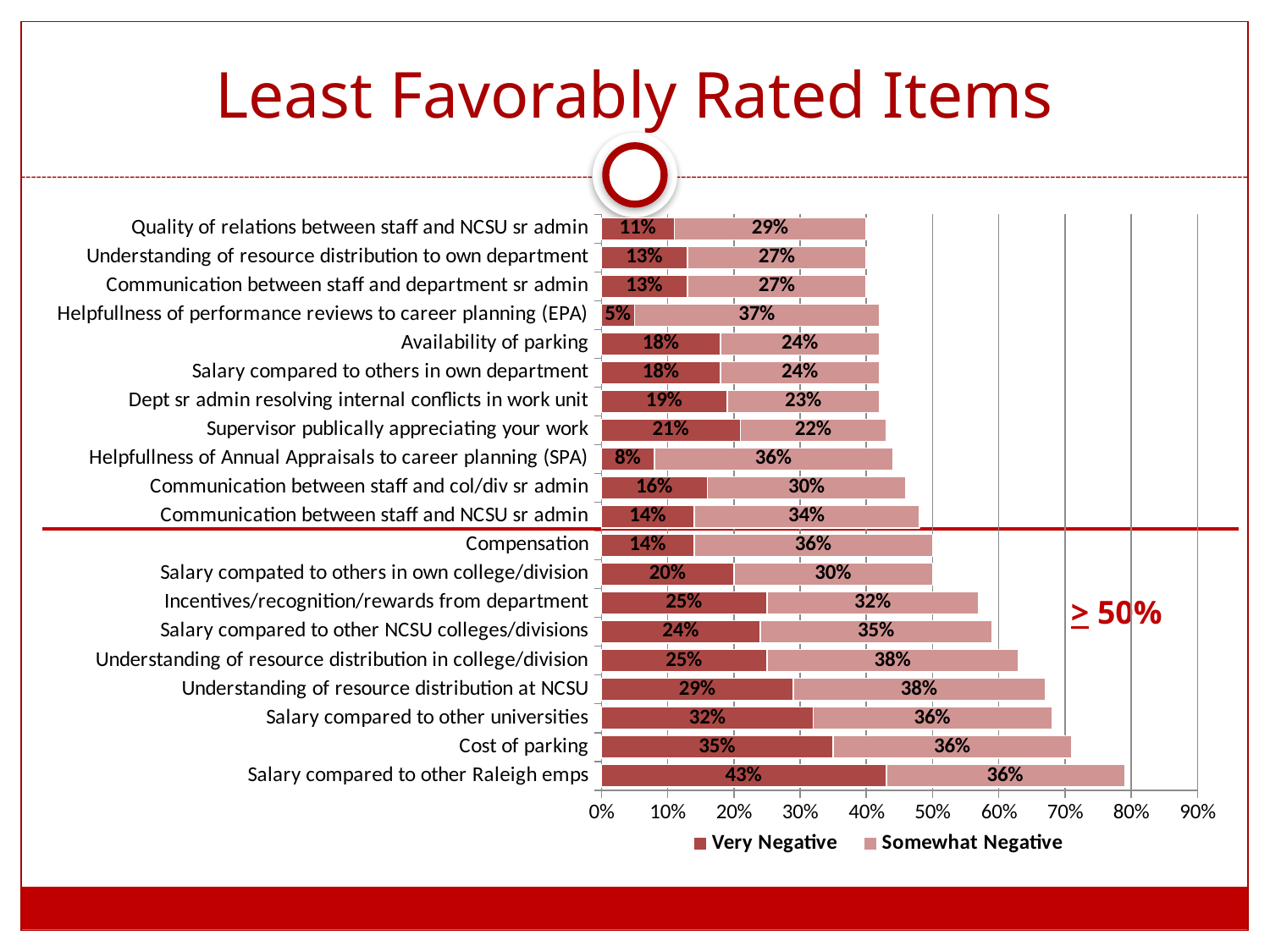
Which item has the highest Very Negative value? Salary compared to other Raleigh emps Which has a larger Somewhat Negative value: Understanding of resource distribution at NCSU or Communication between staff and col/div sr admin? Understanding of resource distribution at NCSU How many items (categories) are plotted in the chart? 20 What is the total of the stacked bar for Salary compared to other Raleigh emps? 79% What is the Very Negative value for Compensation? 14% What is the title of the chart on the slide? Least Favorably Rated Items How many series does the legend list? 2 Which item has the lowest Very Negative value? Helpfullness of performance reviews to career planning (EPA) What is the Very Negative value for Cost of parking? 35% What is the Somewhat Negative value for Helpfullness of performance reviews to career planning (EPA)? 37% What is the difference between the Very Negative values for Salary compared to other universities and Availability of parking? 14% What type of chart is shown on the slide? Stacked bar chart